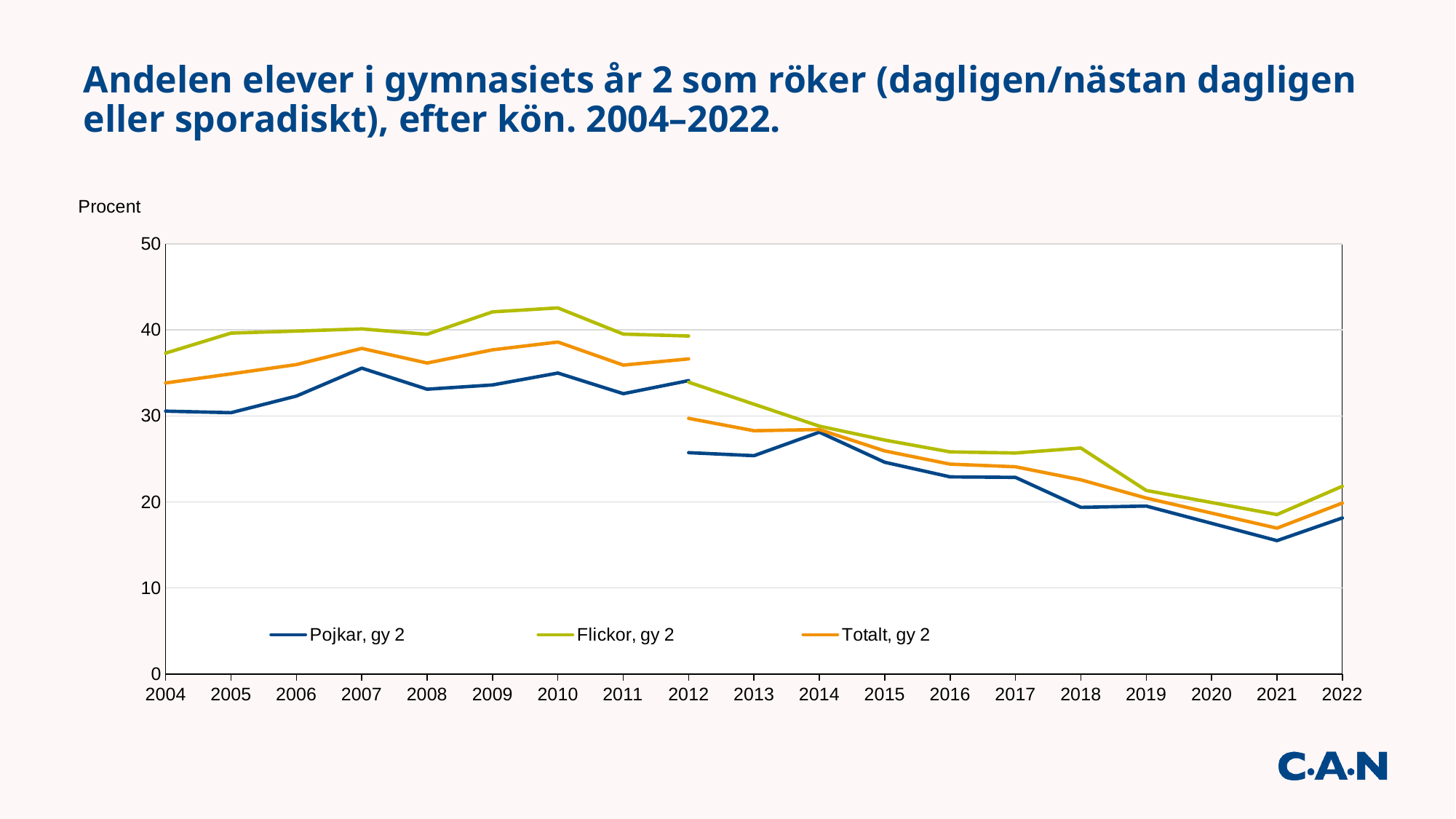
How many series does the legend list? 3 Is the value for Flickor, gy 2 in 2010 greater or less than 40? greater What kind of chart is shown on the slide? line chart Is the value for Totalt, gy 2 in 2004 greater or less than 30? greater How many years are plotted along the x axis? 19 Does the value for Pojkar, gy 2 rise or fall overall from 2004 to 2022? fall In which year is the value for Flickor, gy 2 lowest? 2021 In 2010, which series has the higher value, Pojkar, gy 2 or Flickor, gy 2? Flickor, gy 2 What label is shown above the y axis? Procent Is the value for Pojkar, gy 2 in 2014 greater or less than 30? less In which year is the value for Pojkar, gy 2 lowest? 2021